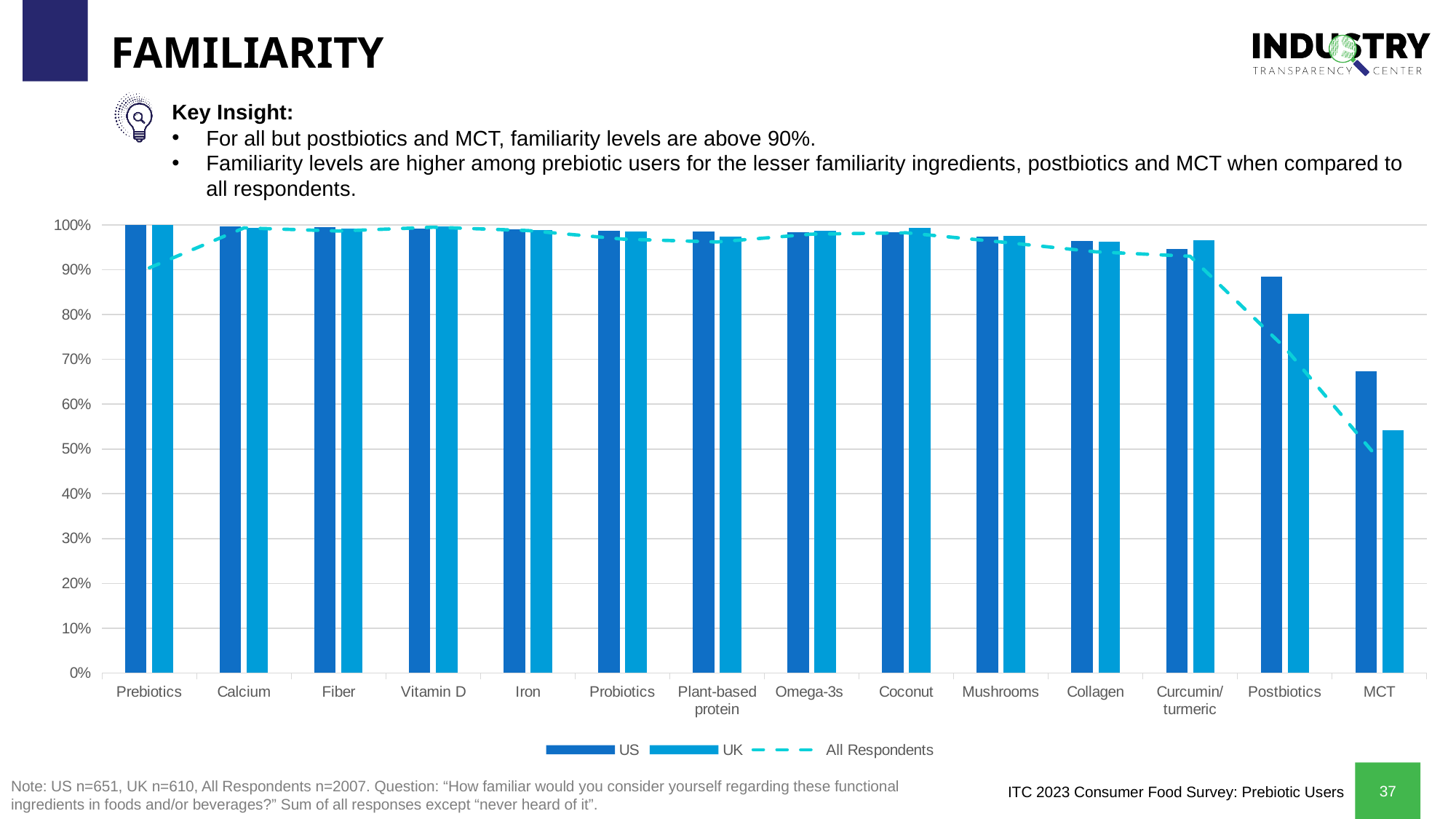
How many ingredient categories are shown on the x axis of the chart? 14 What kind of chart is shown on the slide? bar chart (with a dashed line series) Do the familiarity values generally rise or fall moving from left to right along the x axis? fall Is the UK value for MCT greater or less than 60%? less Is the US value for MCT greater or less than 60%? greater Is the US value for Postbiotics greater or less than 90%? less Which ingredient has the lowest familiarity value for the US series? MCT For Postbiotics, which is larger, the US value or the UK value? US Which ingredient has the lowest familiarity value for the UK series? MCT How many series does the chart legend list? 3 For MCT, which is larger, the US value or the UK value? US